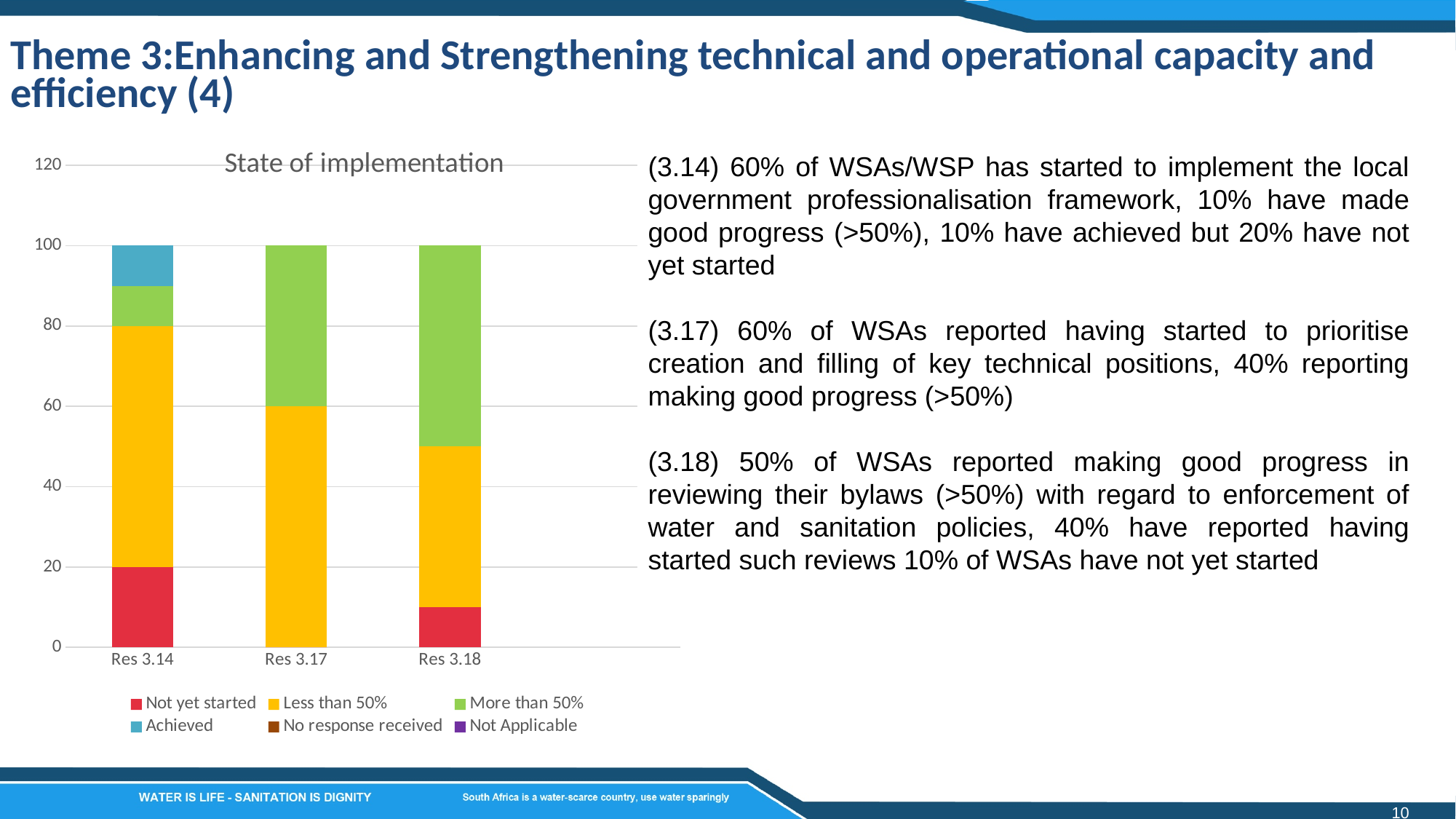
Which category has the largest 'Not yet started' segment? Res 3.14 What colour represents the 'Not yet started' series in the chart? Red What is the title of the chart? State of implementation What is the total height of the stacked bar for Res 3.17? 100 Is the 'Achieved' segment for Res 3.14 greater or less than 20? less Which is larger, the 'Less than 50%' segment for Res 3.17 or for Res 3.18? Res 3.17 How many series does the chart legend list? 6 How many categories are shown on the x axis of the chart? 3 What type of chart is shown on the slide? Stacked bar chart Which is larger, the 'More than 50%' segment for Res 3.17 or for Res 3.18? Res 3.18 What is the value of the 'Not yet started' segment for Res 3.14? 20 What is the value of the 'Less than 50%' segment for Res 3.17? 60